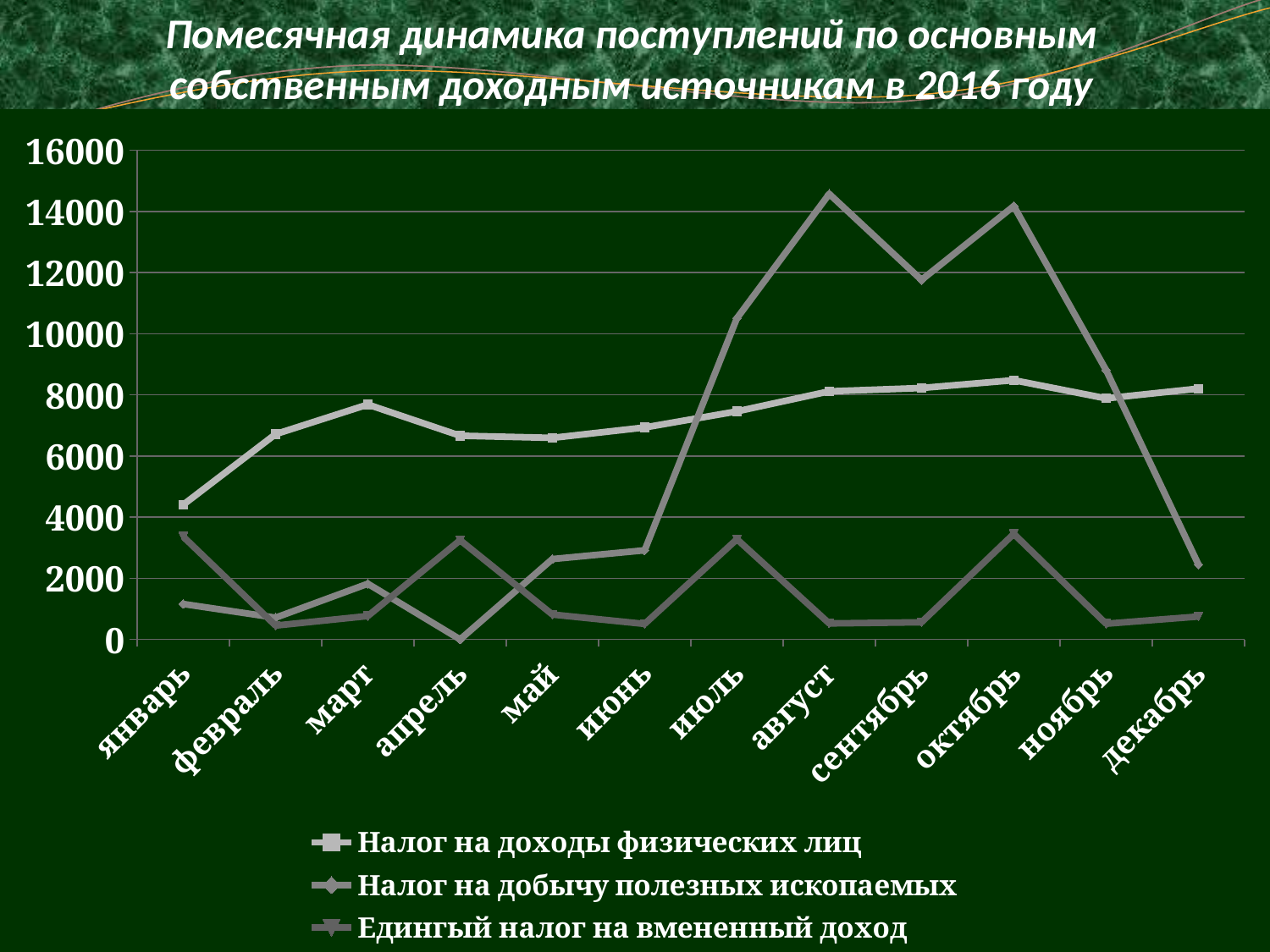
How many series does the legend list? 3 Which series is listed first in the legend? Налог на доходы физических лиц Is the value for Налог на доходы физических лиц in октябрь greater or less than 8000? greater What is the title of the slide? Помесячная динамика поступлений по основным собственным доходным источникам в 2016 году How many months are plotted along the x axis? 12 Is the value for Налог на доходы физических лиц in июль greater or less than 6000? greater Is the value for Налог на доходы физических лиц in январь greater or less than 6000? less Which month has the lowest value for Налог на доходы физических лиц? январь Which is larger for Налог на доходы физических лиц: the value in январь or the value in март? март What kind of chart is shown on the slide? line chart Does the line for Налог на доходы физических лиц rise or fall from январь to март? rise In which month does any series reach the highest value on the chart? август